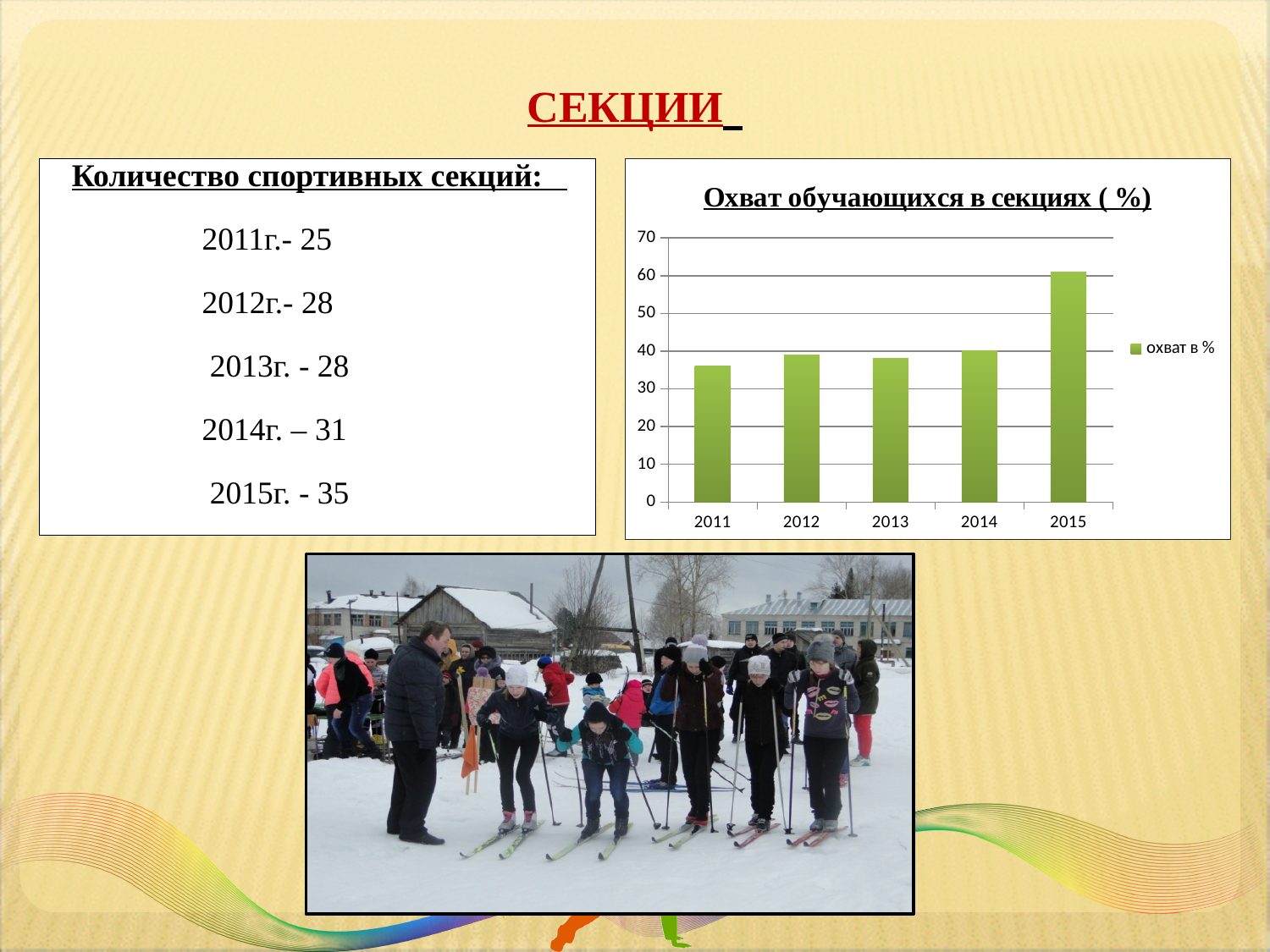
Which is larger in the chart, the value for 2015 or the value for 2014? 2015 How many series does the chart legend list? 1 What is the legend entry of the chart? охват в % What is the title of the chart on the slide? Охват обучающихся в секциях ( %) What kind of chart is shown on the slide? bar chart Which year has the highest value in the chart? 2015 How many years (categories) are shown on the x axis of the chart? 5 Is the value for 2011 greater or less than 40? less Is the value for 2015 higher or lower than the value for 2011? higher Is the value for 2011 greater or less than 30? greater Which is larger in the chart, the value for 2014 or the value for 2011? 2014 Is the value for 2015 greater or less than 50? greater